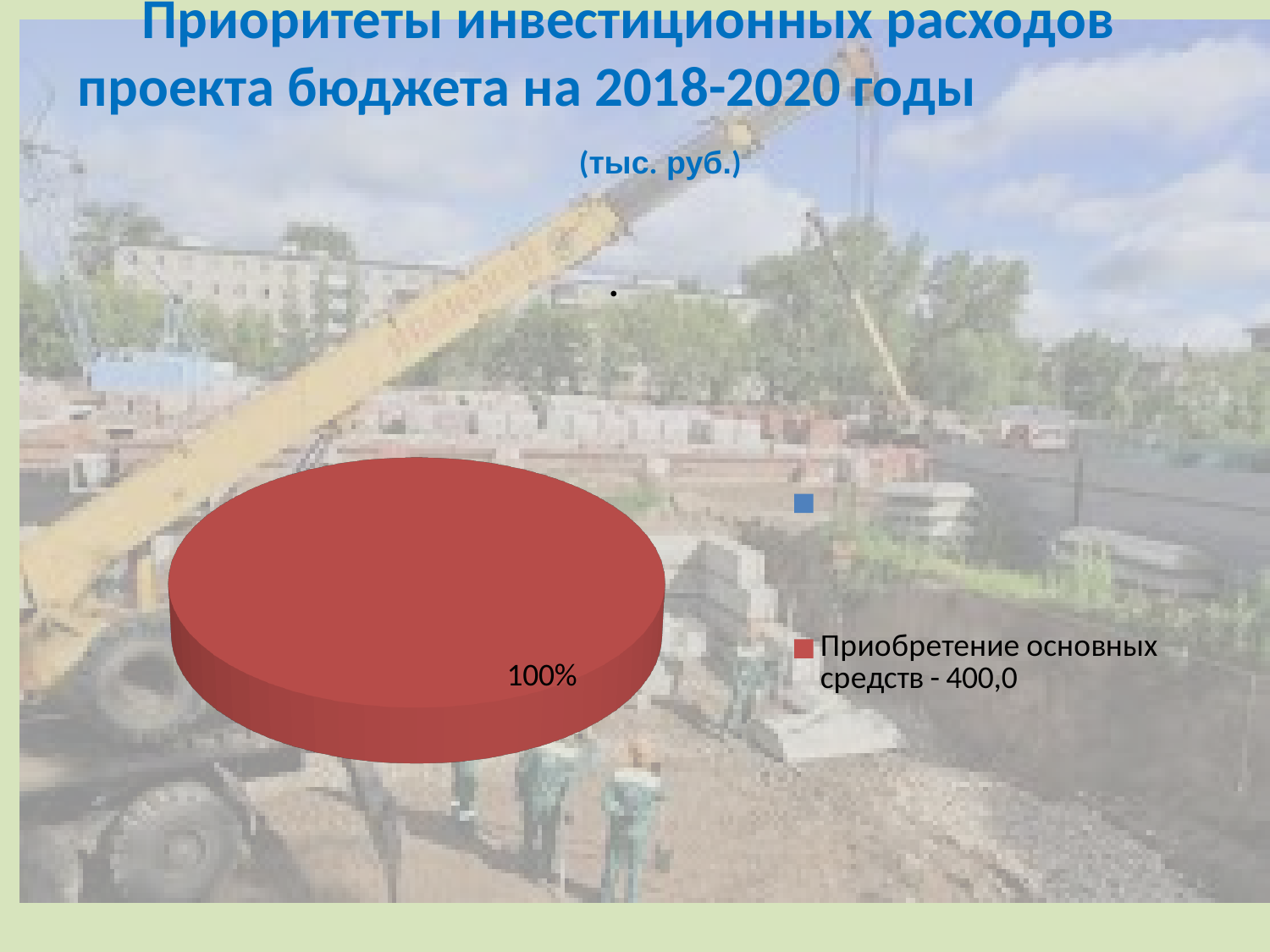
What value is given in the legend for "Приобретение основных средств"? 400,0 What unit is indicated under the chart title? тыс. руб. What percentage label is printed next to the pie slice? 100% What kind of chart is shown on the slide? pie chart How many slices does the pie chart contain? 1 What share of the pie does the slice "Приобретение основных средств" represent? 100% What colour is the pie slice for "Приобретение основных средств"? red